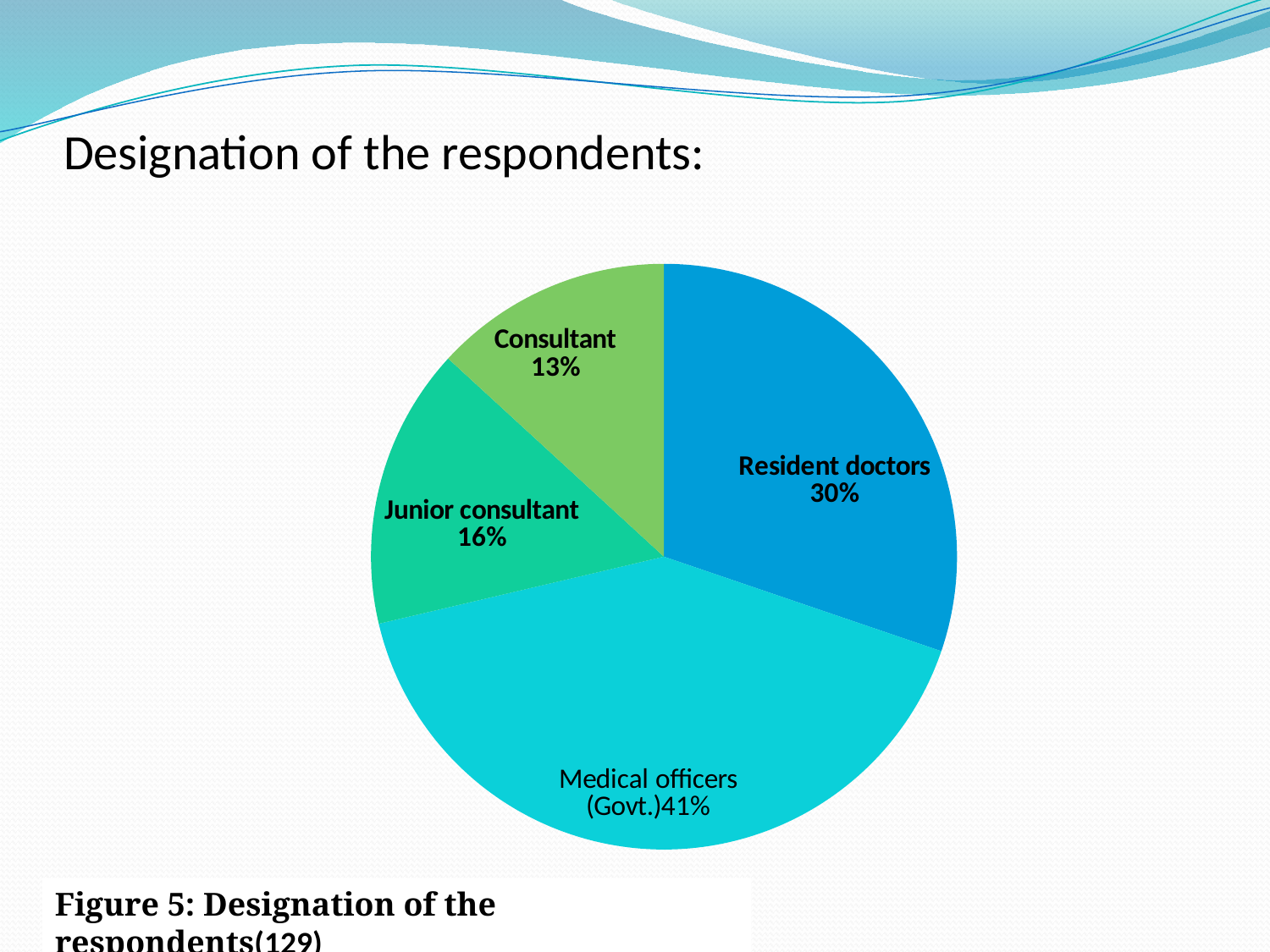
How many designation categories are shown in the pie chart? 4 What is the difference in percentage points between Medical officers (Govt.) and Resident doctors? 11 What share of respondents are Medical officers (Govt.)? 41% What is the title of the slide? Designation of the respondents: Which designation has the smallest share of respondents? Consultant What share of respondents are Resident doctors? 30% What share of respondents are Consultants? 13% Which is larger, the share for Junior consultant or the share for Consultant? Junior consultant What share of respondents are Junior consultants? 16% Which designation has the largest share of respondents? Medical officers (Govt.) What kind of chart is shown on the slide? pie chart What is the combined share of Junior consultant and Consultant? 29%